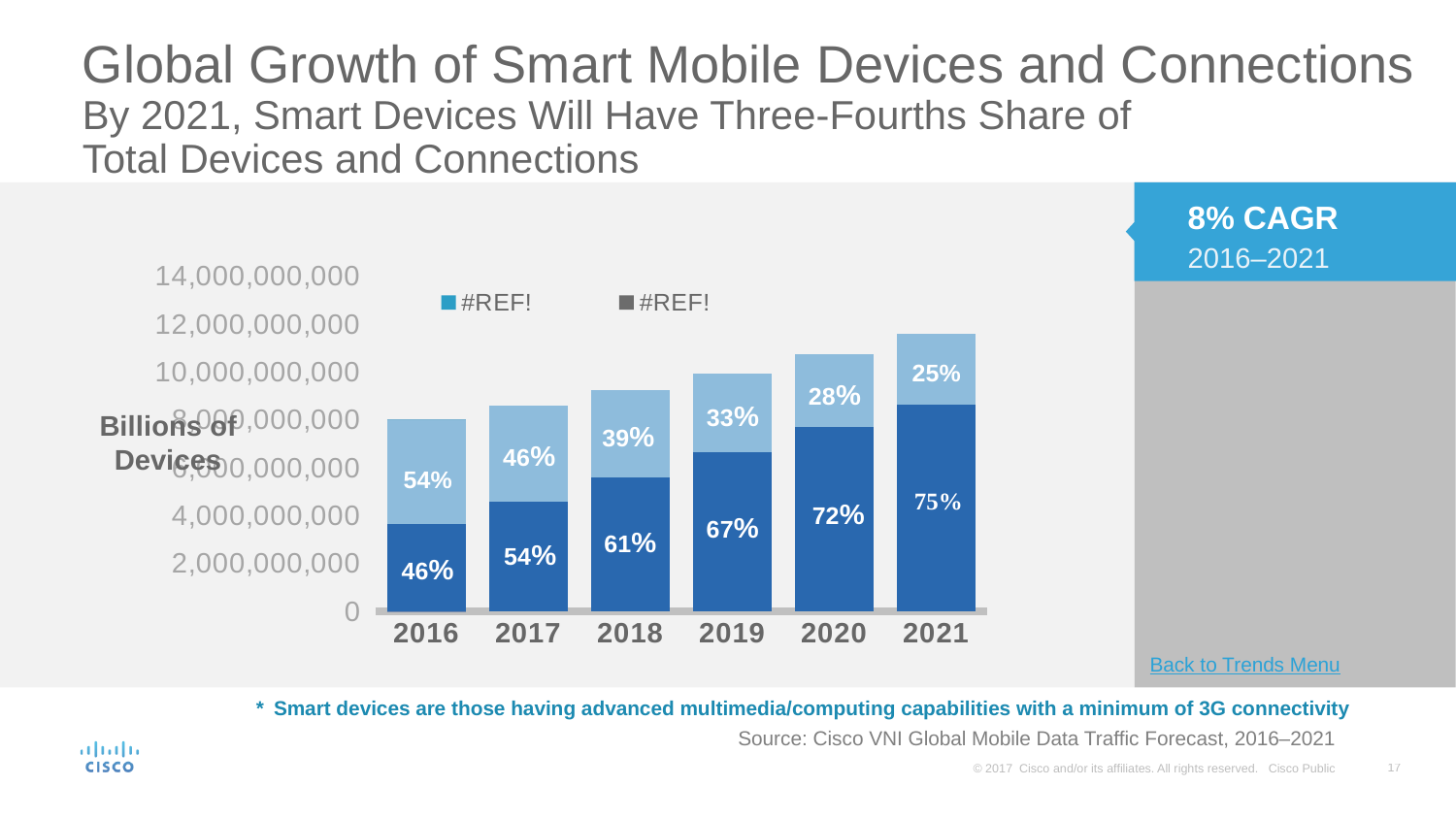
What CAGR for 2016–2021 is stated in the callout next to the chart? 8% CAGR By how many percentage points does the dark blue (bottom) segment's share in 2021 exceed its share in 2016? 29 percentage points What kind of chart is shown on the slide? Stacked bar chart Is the total height of the 2021 bar greater or less than 10,000,000,000? Greater What percentage is labelled on the dark blue (bottom) segment of the 2019 bar? 67% How many series does the chart's legend list? 2 Do the percentages on the dark blue (bottom) segments rise or fall from 2016 to 2021? Rise What percentage is labelled on the light blue (top) segment of the 2021 bar? 25% What percentage is labelled on the light blue (top) segment of the 2018 bar? 39% In which year is the dark blue (bottom) segment's percentage the highest? 2021 How many years are shown along the x axis of the chart? 6 What percentage is labelled on the dark blue (bottom) segment of the 2016 bar? 46%